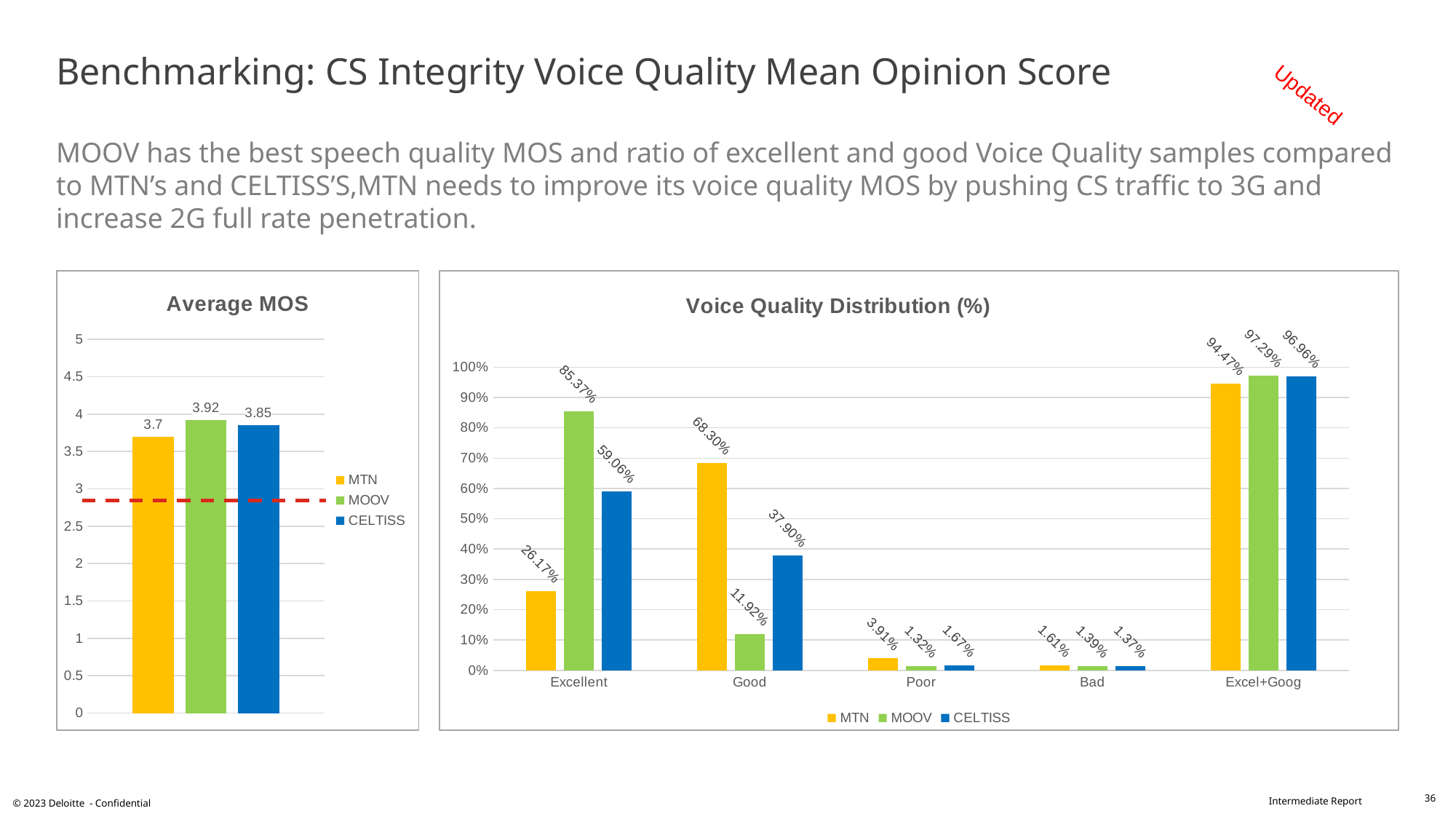
In the Voice Quality Distribution (%) chart, what is the value for MOOV in the Excellent category? 85.37% In the Average MOS chart, what colour is the CELTISS bar? Blue In the Average MOS chart, what is the difference between MOOV's and MTN's values? 0.22 In the Average MOS chart, which operator has the lowest average MOS? MTN In the Voice Quality Distribution (%) chart, what is the difference between MTN's and MOOV's values in the Good category? 56.38% In the Average MOS chart, how many series does the legend list? 3 What kind of chart is the Voice Quality Distribution (%) chart? Bar chart In the Voice Quality Distribution (%) chart, which operator has the highest value in the Poor category? MTN In the Average MOS chart, what is the value for MOOV? 3.92 In the Voice Quality Distribution (%) chart, what is the value for CELTISS in the Good category? 37.90% In the Voice Quality Distribution (%) chart, how many categories are shown on the x axis? 5 In the Voice Quality Distribution (%) chart, which is larger in the Excel+Goog category: MOOV or CELTISS? MOOV